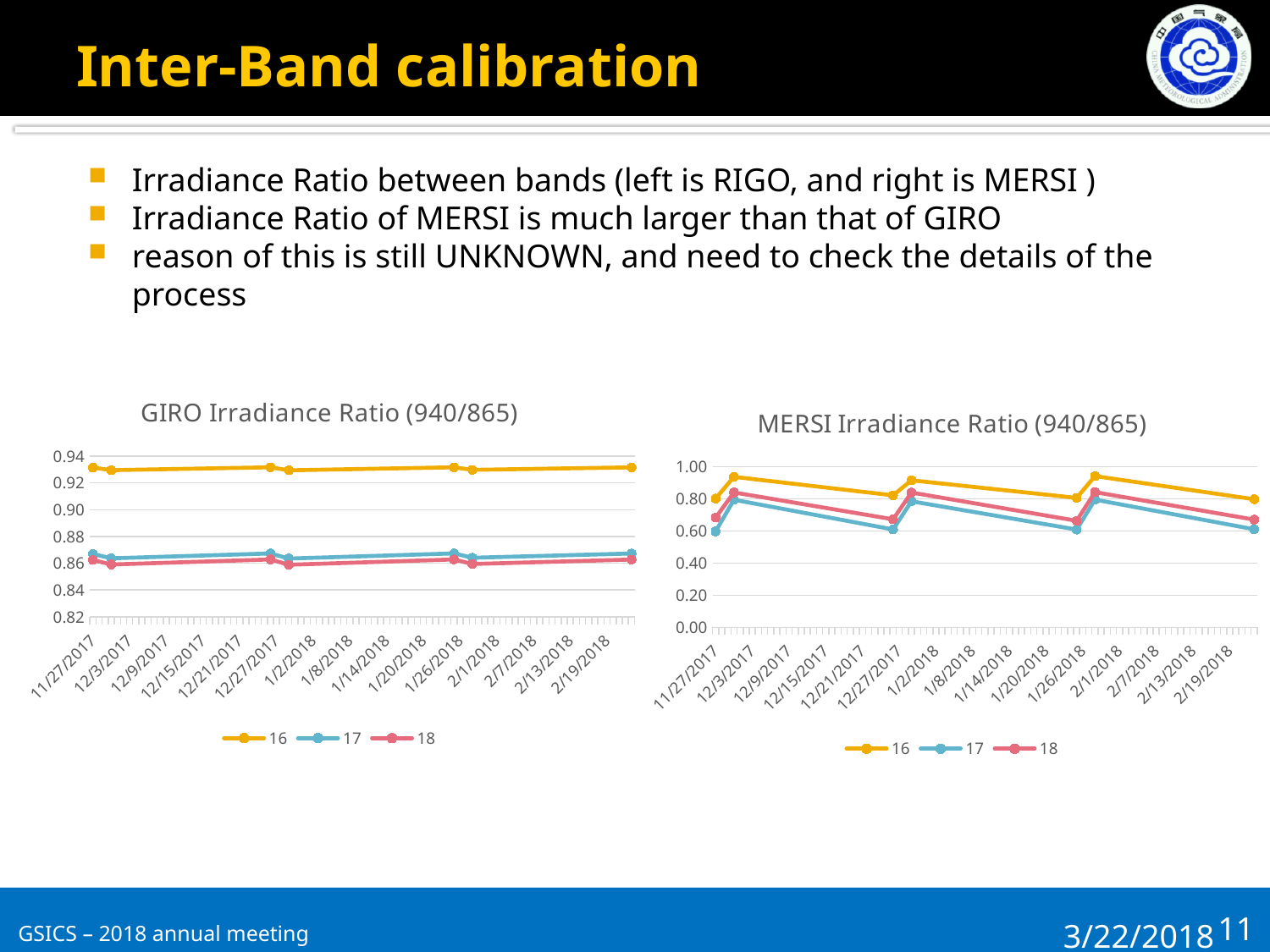
How many series does the legend of the GIRO Irradiance Ratio (940/865) chart list? 3 In the MERSI Irradiance Ratio (940/865) chart, are the values for series 16 greater or less than 1.00? less In the GIRO Irradiance Ratio (940/865) chart, are the values for series 16 greater or less than 0.90? greater In the MERSI Irradiance Ratio (940/865) chart, are the values for series 17 greater or less than 0.40? greater What kind of chart is the MERSI Irradiance Ratio (940/865) chart? line chart What is the title of the chart on the left side of the slide? GIRO Irradiance Ratio (940/865) What are the legend entries of the MERSI Irradiance Ratio (940/865) chart? 16, 17, 18 What kind of chart is the GIRO Irradiance Ratio (940/865) chart? line chart How many series does the legend of the MERSI Irradiance Ratio (940/865) chart list? 3 In the GIRO Irradiance Ratio (940/865) chart, which series has the highest values, 16 or 17? 16 In the MERSI Irradiance Ratio (940/865) chart, which series has the highest values overall? 16